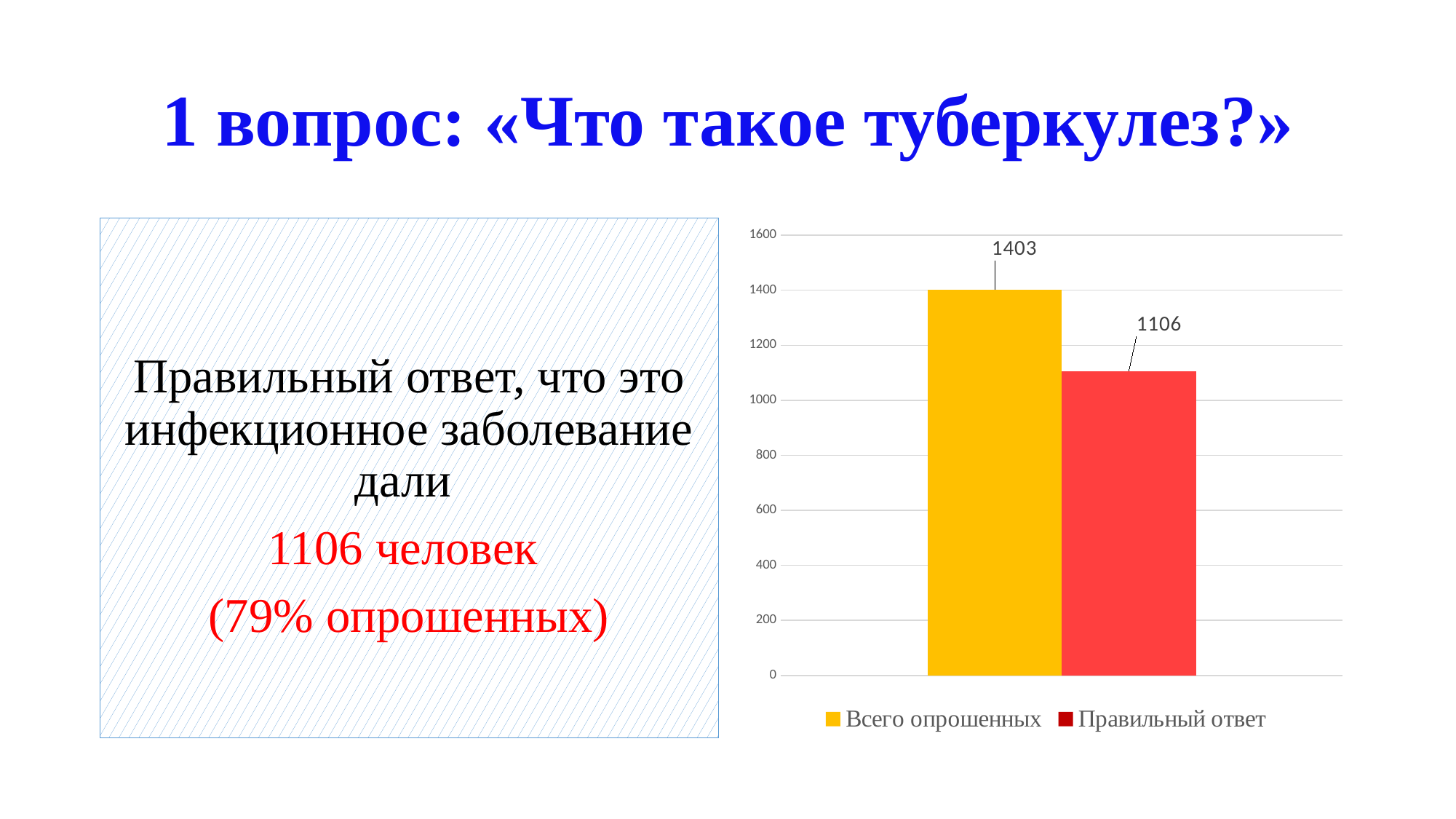
Is the value for Всего опрошенных greater or less than 1400? greater How many series does the legend list? 2 What is the value for Правильный ответ? 1106 What is the maximum value shown on the vertical axis? 1600 What is the value for Всего опрошенных? 1403 Which series has the higher value, Всего опрошенных or Правильный ответ? Всего опрошенных Which series has the lowest value? Правильный ответ What colour is the bar for Всего опрошенных? yellow What is the difference between Всего опрошенных and Правильный ответ? 297 What kind of chart is shown on the slide? bar chart Is the value for Правильный ответ greater or less than 1200? less